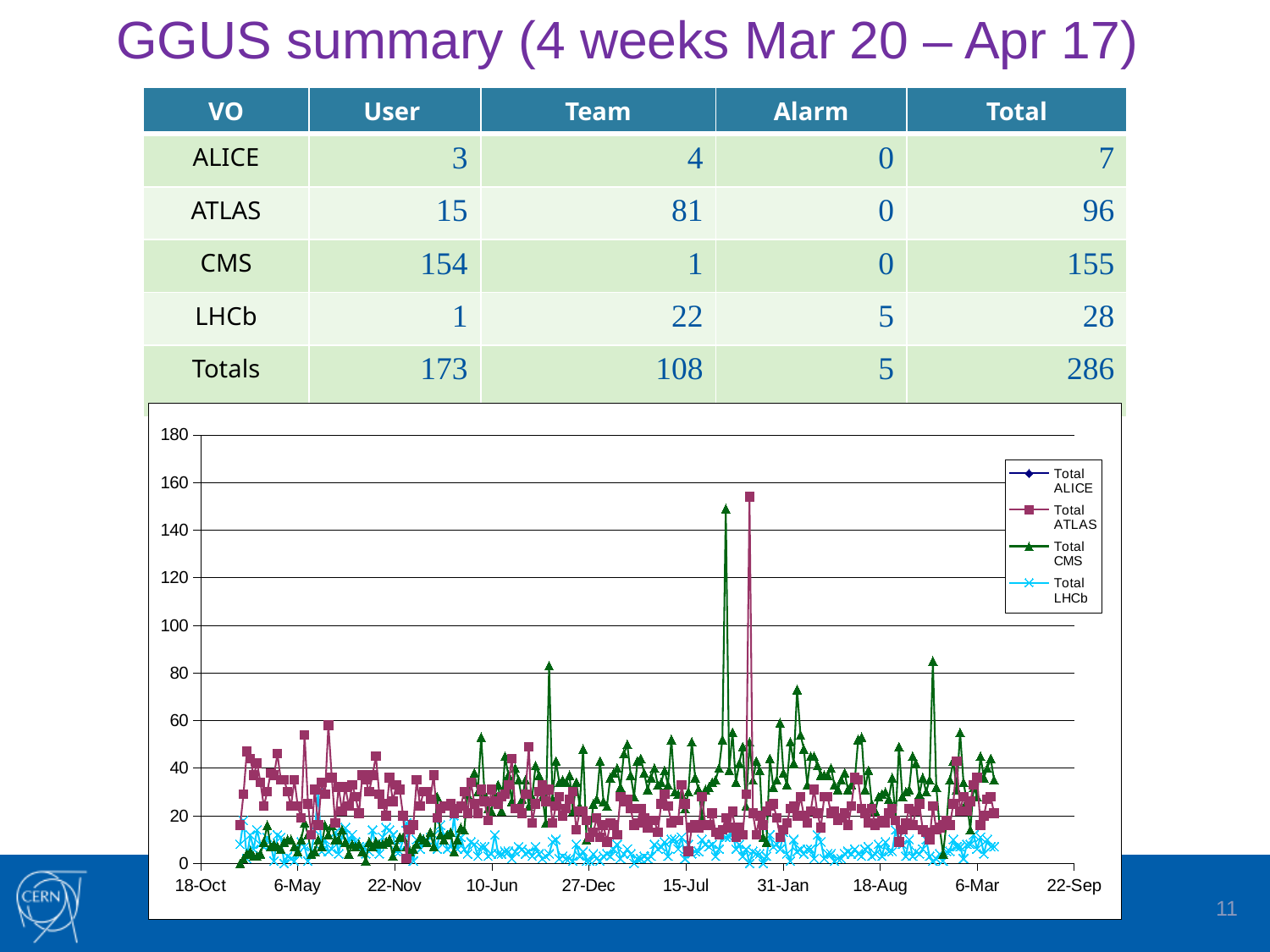
How many series does the chart legend list? 4 Is the highest peak of the Total ATLAS series greater or less than 160? less Is the highest peak of the Total CMS series greater or less than 120? greater What is the highest value shown on the chart's y axis? 180 What kind of chart is shown on the slide? line chart Is the highest peak of the Total LHCb series greater or less than 40? less Which series are listed in the chart legend? Total ALICE, Total ATLAS, Total CMS, Total LHCb How many date labels are shown along the chart's x axis? 10